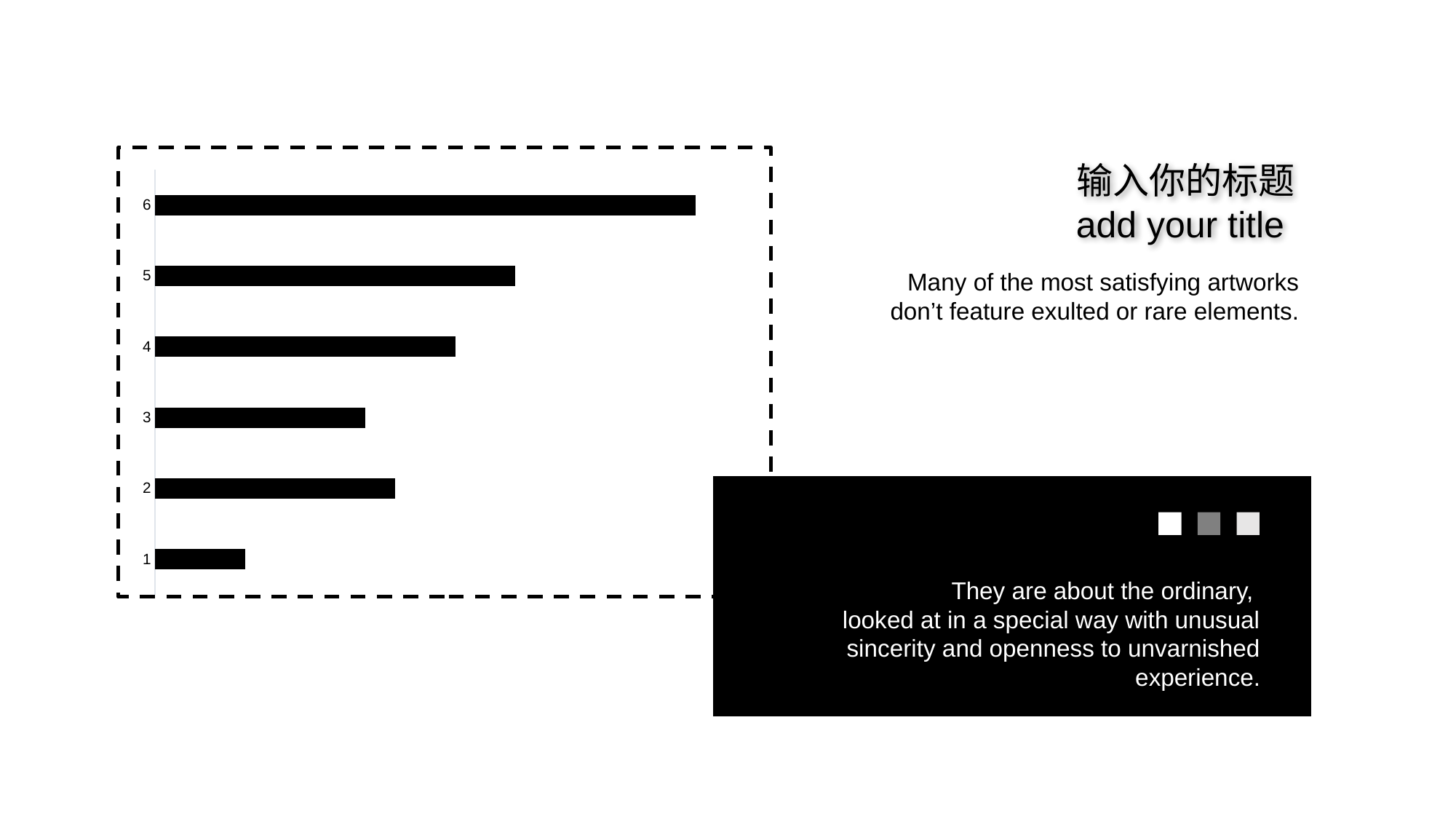
What colour are the bars in the chart? black Which bar is longer, category 3 or category 5? 5 Which category has the shortest bar in the chart? 1 Do the bar lengths generally increase or decrease going from category 1 up to category 6? increase Are the bars in the chart horizontal or vertical? horizontal Which bar is longer, category 4 or category 1? 4 What kind of chart is shown on the slide? bar chart Which category has the longest bar in the chart? 6 Which bar is longer, category 1 or category 6? 6 How many categories (bars) does the chart show? 6